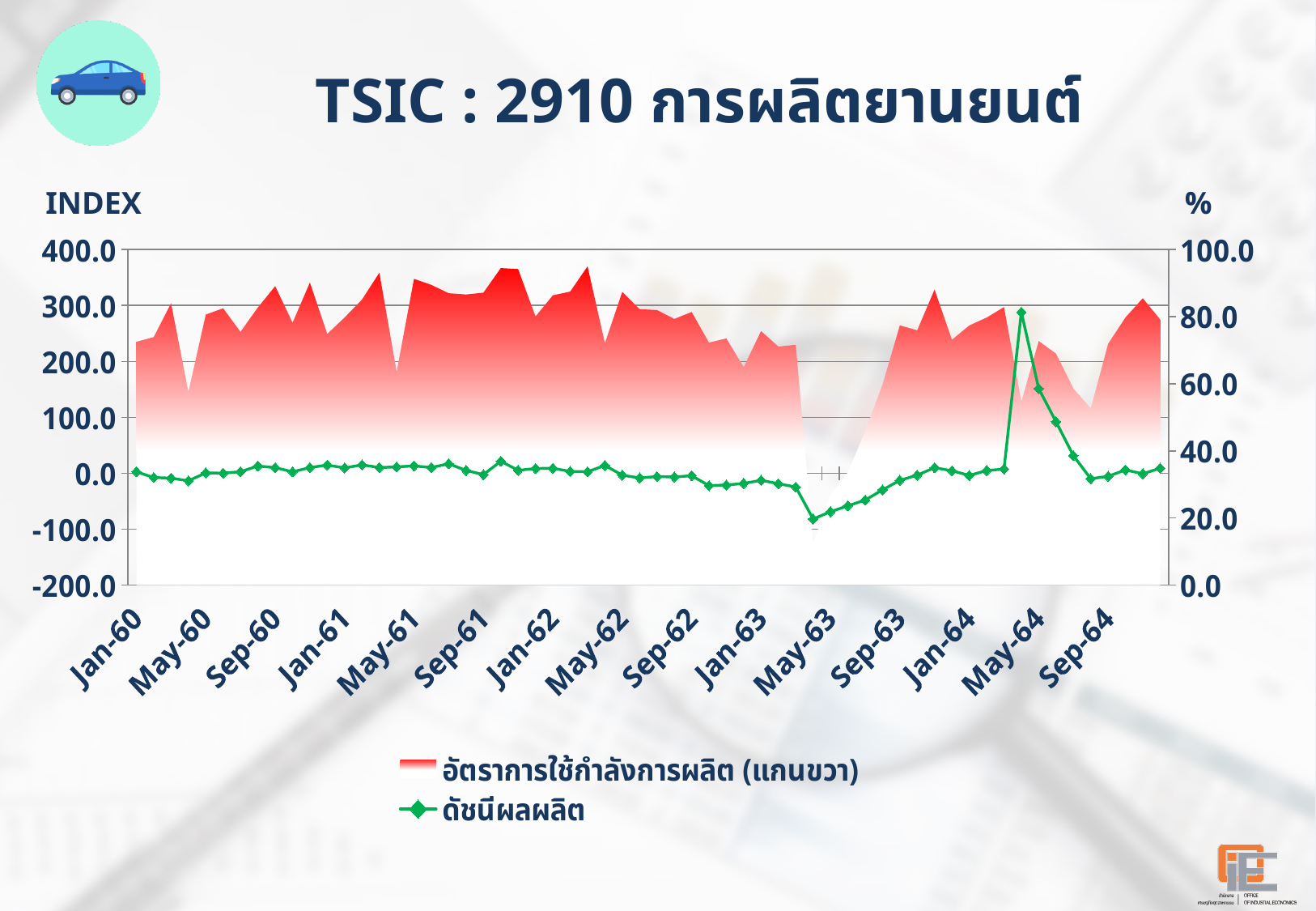
Is the value of ดัชนีผลผลิต at Jan-60 greater or less than 100.0? less Between May-64 and Sep-64, does the green line ดัชนีผลผลิต rise or fall? fall What kind of chart is used for the green series ดัชนีผลผลิต? line chart Is the value of ดัชนีผลผลิต at May-64 greater or less than 200.0? less Is the value of ดัชนีผลผลิต at May-63 greater or less than 0.0? less What are the labels of the left and right vertical axes? INDEX (left) and % (right) What is the title of the chart? TSIC : 2910 การผลิตยานยนต์ What kind of chart is used for the red series อัตราการใช้กำลังการผลิต (แกนขวา)? area chart Between May-63 and May-64, does the green line ดัชนีผลผลิต rise or fall? rise How many series does the legend list? 2